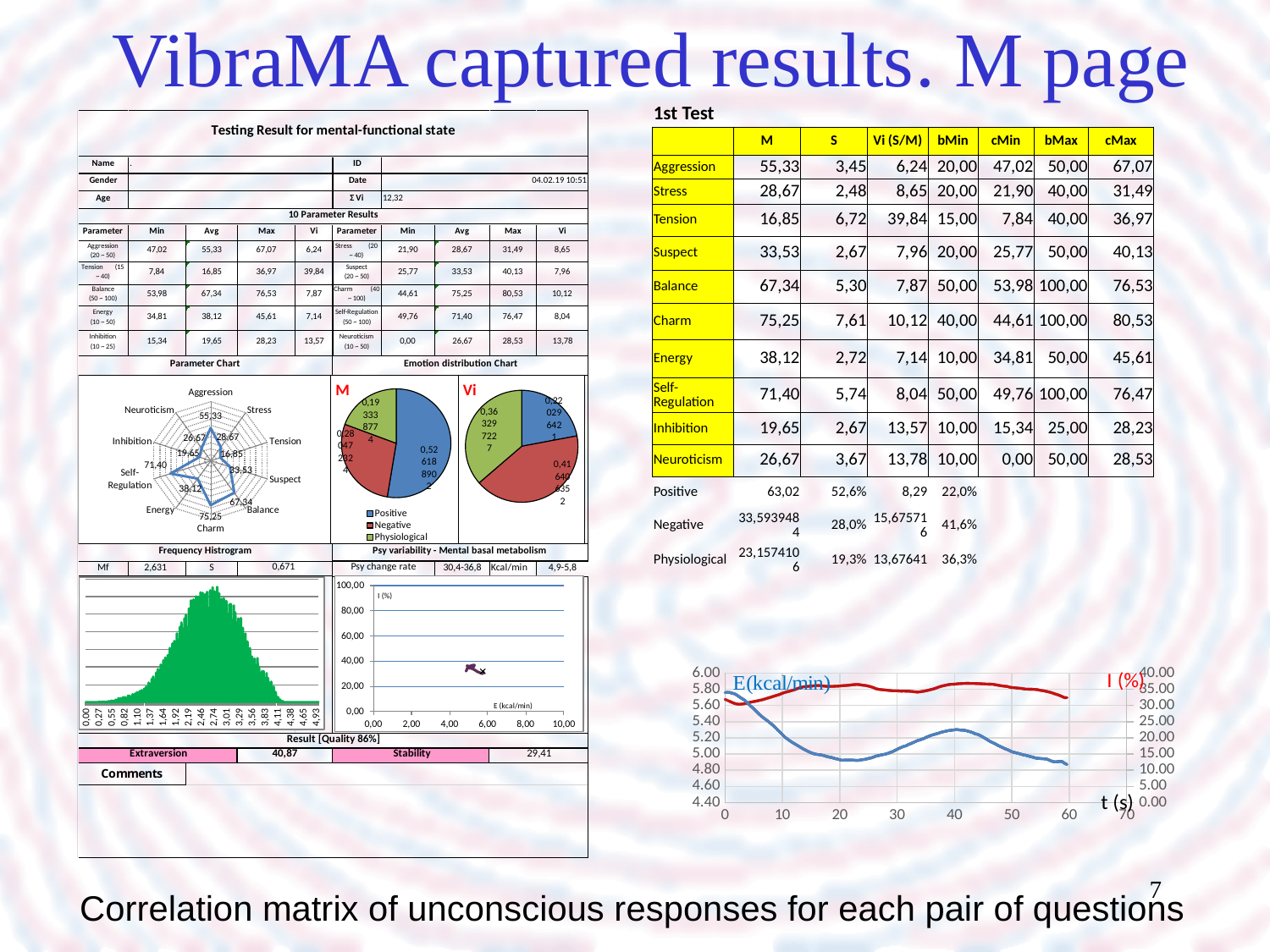
In the Emotion distribution Chart, which slice is the largest in the M pie? Positive In the Emotion distribution Chart, how many entries does the legend list? 3 In the Parameter Chart radar chart, what is the value for Charm? 75,25 In the Parameter Chart radar chart, which parameter has the lowest value? Tension What kind of chart is the Frequency Histogram? Bar chart In the Parameter Chart radar chart, which is larger, the value for Balance or the value for Energy? Balance In the Parameter Chart radar chart, what is the value for Tension? 16,85 What kind of chart is the Parameter Chart? Radar chart In the Parameter Chart radar chart, what is the difference between the values for Self-Regulation and Inhibition? 51,75 In the Parameter Chart radar chart, which parameter has the highest value? Charm In the Parameter Chart radar chart, how many parameters are plotted? 10 In the Emotion distribution Chart, which slice is the largest in the Vi pie? Negative